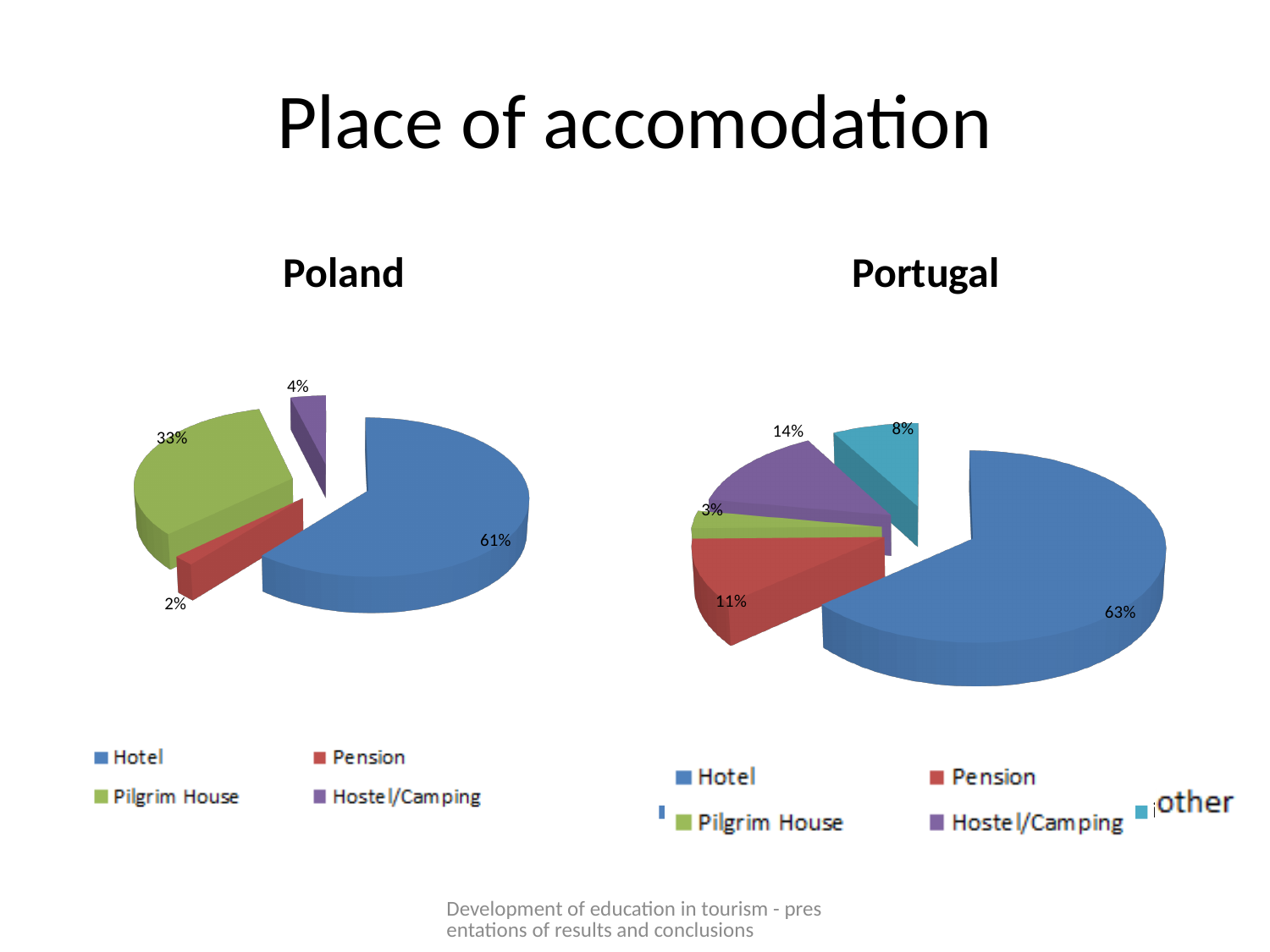
What type of chart is used for the Poland data? Pie chart What is the difference between the Hotel share in the Portugal chart and the Hotel share in the Poland chart? 2% In the Portugal chart, what share is shown for the 'other' category? 8% In the Poland chart, what share of respondents stayed in a Hotel? 61% In the Poland chart, which category has the smallest share? Pension In the Poland chart, what share is shown for Pension? 2% In the Portugal chart, which category has the smallest share? Pilgrim House In the Poland chart, what share is shown for Pilgrim House? 33% In the Portugal chart, what share is shown for Hostel/Camping? 14% How many categories does the legend of the Portugal chart list? 5 In the Portugal chart, which is larger: the share for Pension or the share for Hostel/Camping? Hostel/Camping In the Portugal chart, which category has the largest share? Hotel